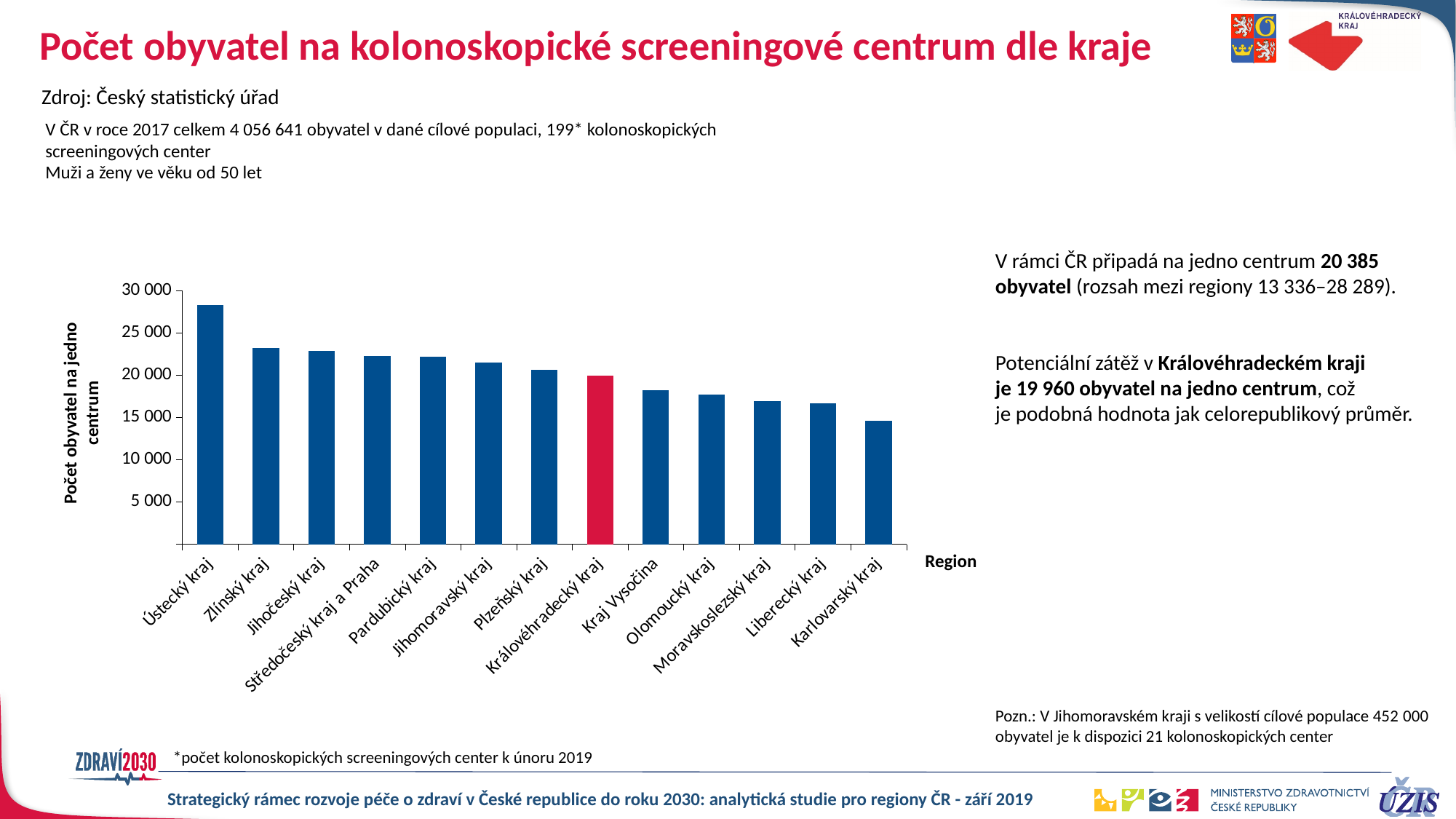
Which region has the lowest number of inhabitants per colonoscopy screening centre in the chart? Karlovarský kraj Which region has a larger value, Zlínský kraj or Liberecký kraj? Zlínský kraj Is the value for Liberecký kraj greater or less than 20 000? less Is the value for Zlínský kraj greater or less than 20 000? greater Is the value for Olomoucký kraj greater or less than 20 000? less How many regions are shown on the x axis of the chart? 13 Which region's bar is highlighted in red in the chart? Královéhradecký kraj Which region has the highest number of inhabitants per colonoscopy screening centre in the chart? Ústecký kraj What kind of chart is shown on the slide? bar chart Do the bar values rise or fall from left to right along the x axis? fall According to the slide, how many inhabitants per centre does Královéhradecký kraj have? 19 960